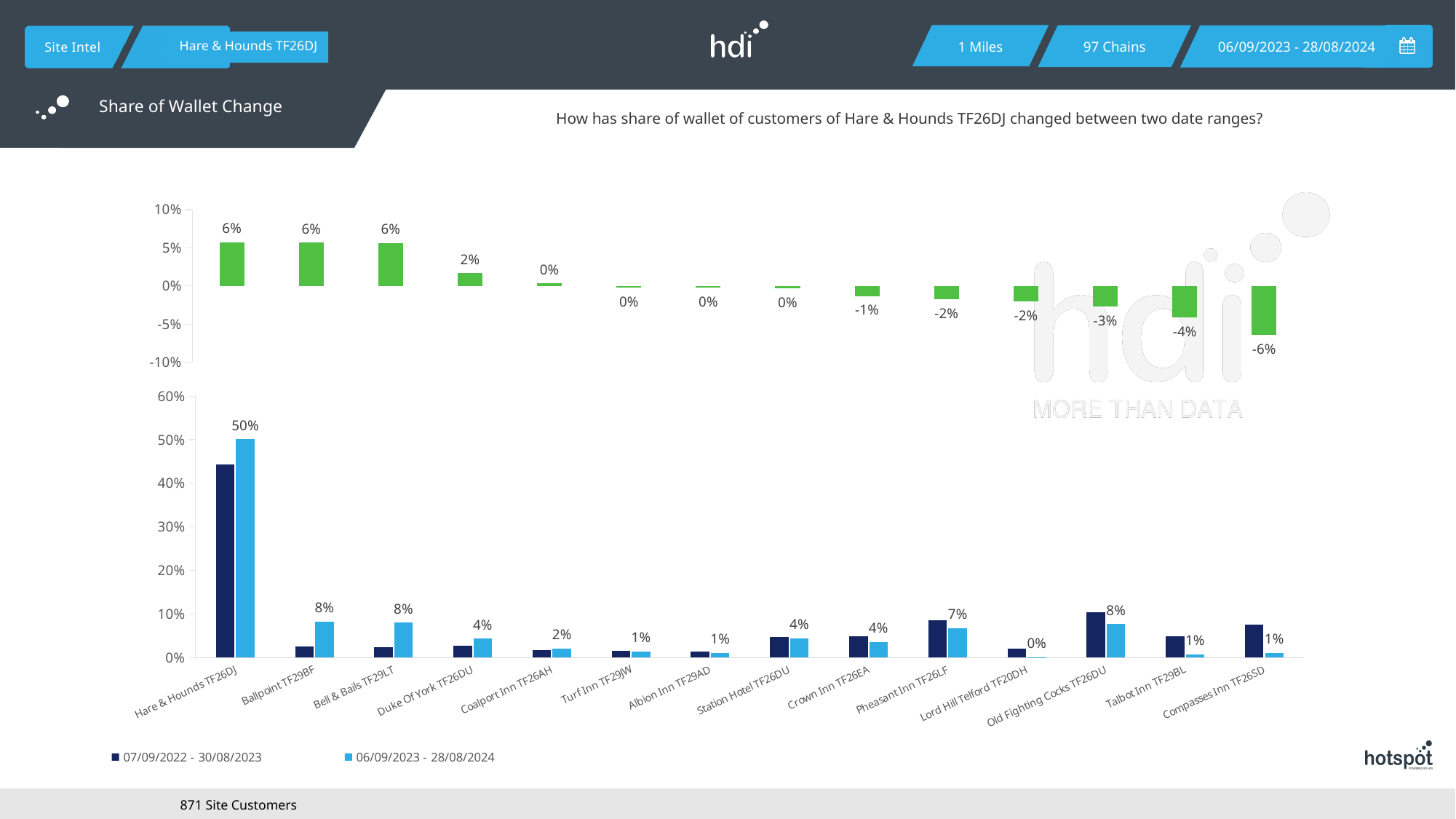
In the bottom chart, what is the share of wallet for Hare & Hounds TF26DJ in the 06/09/2023 - 28/08/2024 period? 50% In the top chart (share of wallet change), do the values rise or fall moving from left to right along the x axis? fall In the top chart (share of wallet change), what is the difference between the value for Hare & Hounds TF26DJ and the value for Talbot Inn TF29BL? 10 percentage points How many categories are shown on the x axis of the bottom chart? 14 In the bottom chart, what is the share of wallet for Lord Hill Telford TF20DH in the 06/09/2023 - 28/08/2024 period? 0% In the top chart (share of wallet change), what is the value for Duke Of York TF26DU? 2% In the top chart (share of wallet change), what is the value for Compasses Inn TF26SD? -6% In the bottom chart, for Hare & Hounds TF26DJ, which period has the larger share of wallet? 06/09/2023 - 28/08/2024 In the bottom chart, is the value for Hare & Hounds TF26DJ in the 07/09/2022 - 30/08/2023 period greater or less than 40%? greater In the bottom chart, what is the share of wallet for Pheasant Inn TF26LF in the 06/09/2023 - 28/08/2024 period? 7% In the top chart (share of wallet change), which category has the lowest value? Compasses Inn TF26SD How many series does the legend of the bottom chart list? 2